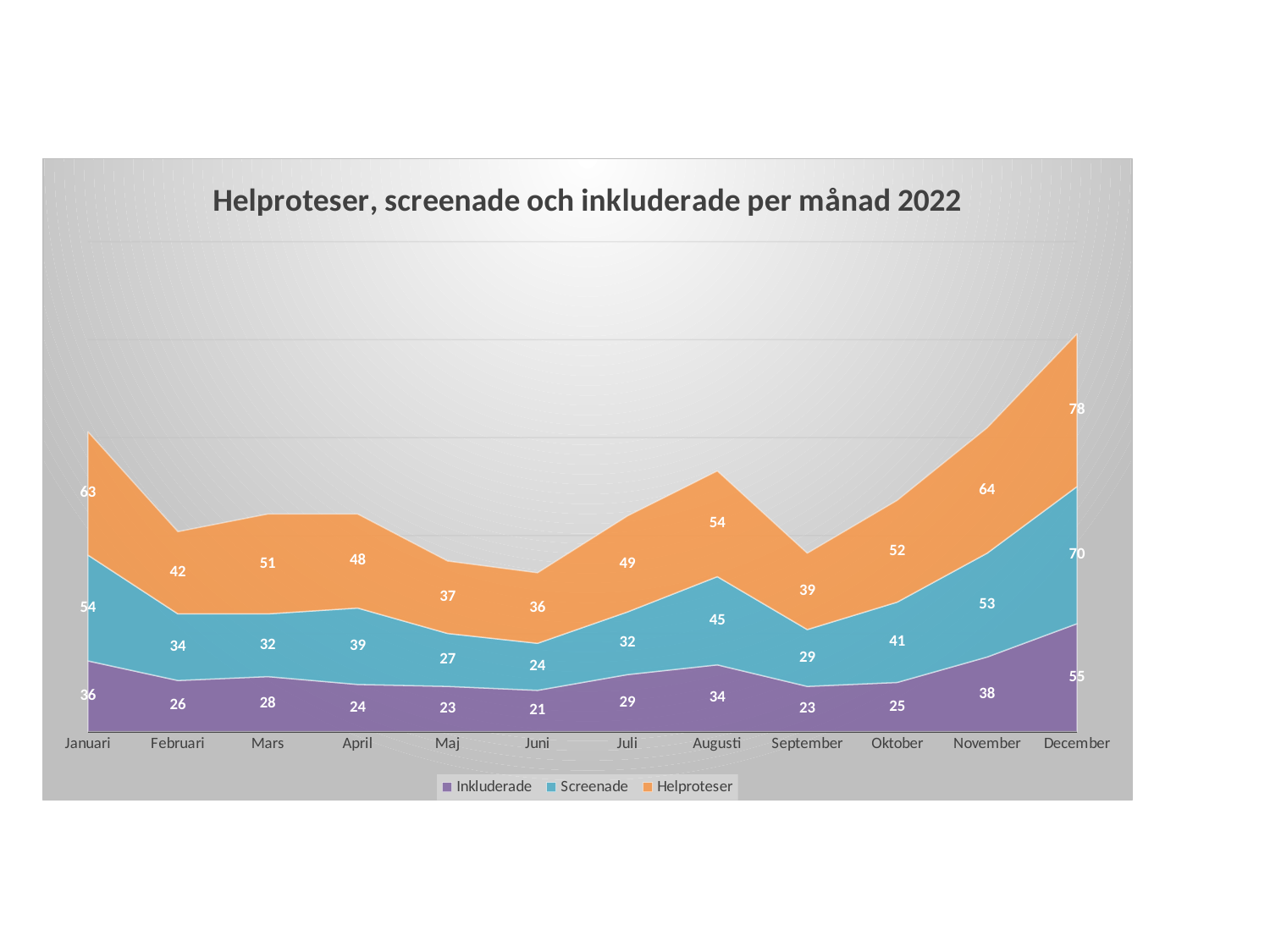
Which month has the highest value for Inkluderade? December What kind of chart is shown on the slide? Stacked area chart Which is larger, the Screenade value for Augusti or for Oktober? Augusti What is the total of the three series for December? 203 How many series does the legend list? 3 Which month has the lowest value for Screenade? Juni How many months are shown on the x axis? 12 What is the value for Screenade in Januari? 54 What is the title of the chart? Helproteser, screenade och inkluderade per månad 2022 What is the difference between the Helproteser values for December and Januari? 15 What is the value for Inkluderade in Juni? 21 What is the value for Helproteser in December? 78